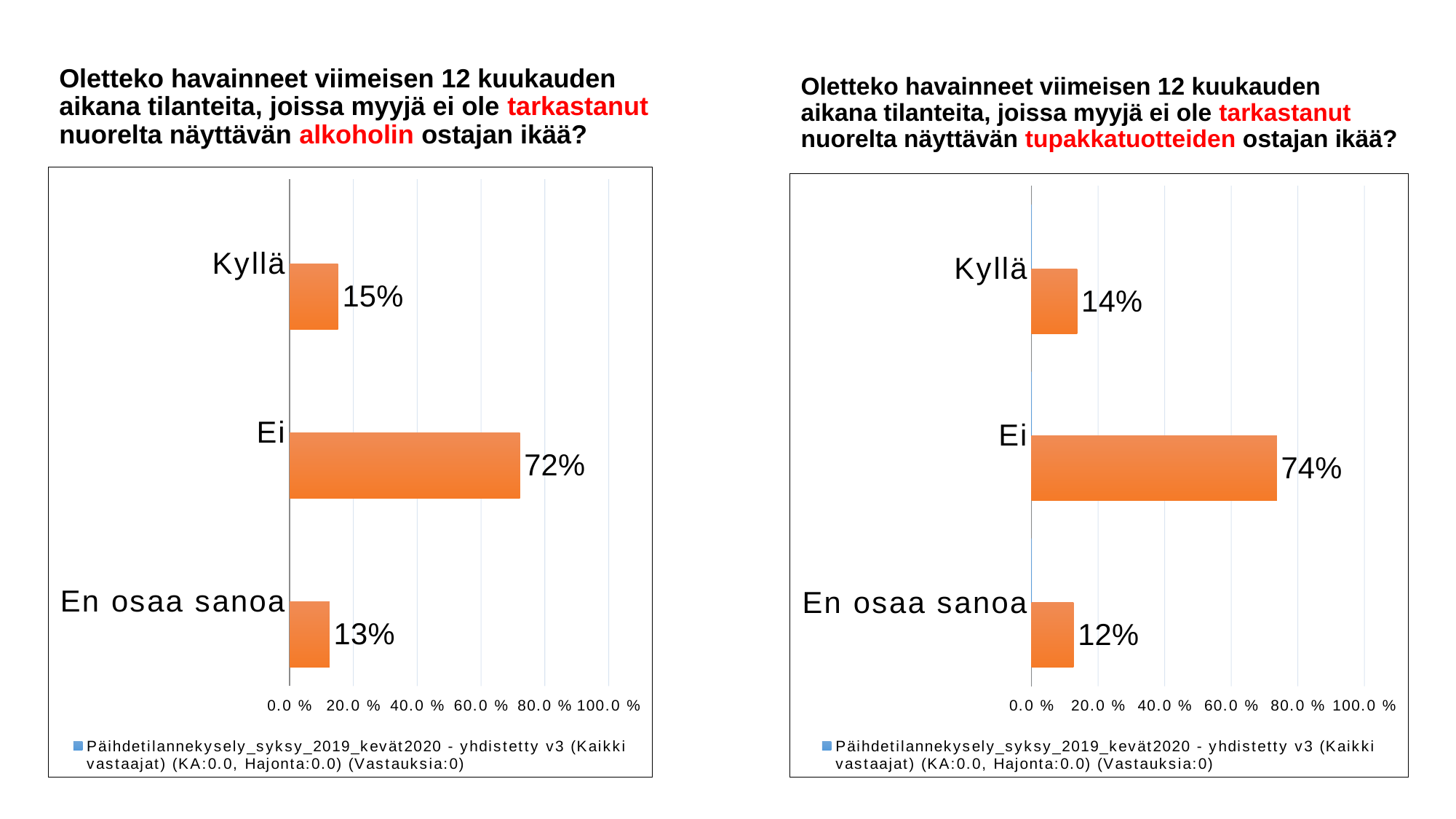
How many series does the legend of the left chart (alkoholin) list? 1 Which is larger: the value for Ei in the left chart (alkoholin) or the value for Ei in the right chart (tupakkatuotteiden)? Ei in the right chart (tupakkatuotteiden) In the right chart (tupakkatuotteiden), what is the difference between Ei and Kyllä? 60% In the right chart (tupakkatuotteiden), is the value for Ei greater or less than 60.0 %? greater How many categories does the left chart (alkoholin) show? 3 In the left chart (alkoholin), which category has the lowest value? En osaa sanoa In the right chart (tupakkatuotteiden), which category has the highest value? Ei In the right chart (tupakkatuotteiden), what is the value for En osaa sanoa? 12% What kind of chart is the right chart (tupakkatuotteiden)? bar chart In the left chart (alkoholin), what is the value for Kyllä? 15% In the left chart (alkoholin), what is the difference between Kyllä and En osaa sanoa? 2% In the left chart (alkoholin), what is the value for Ei? 72%